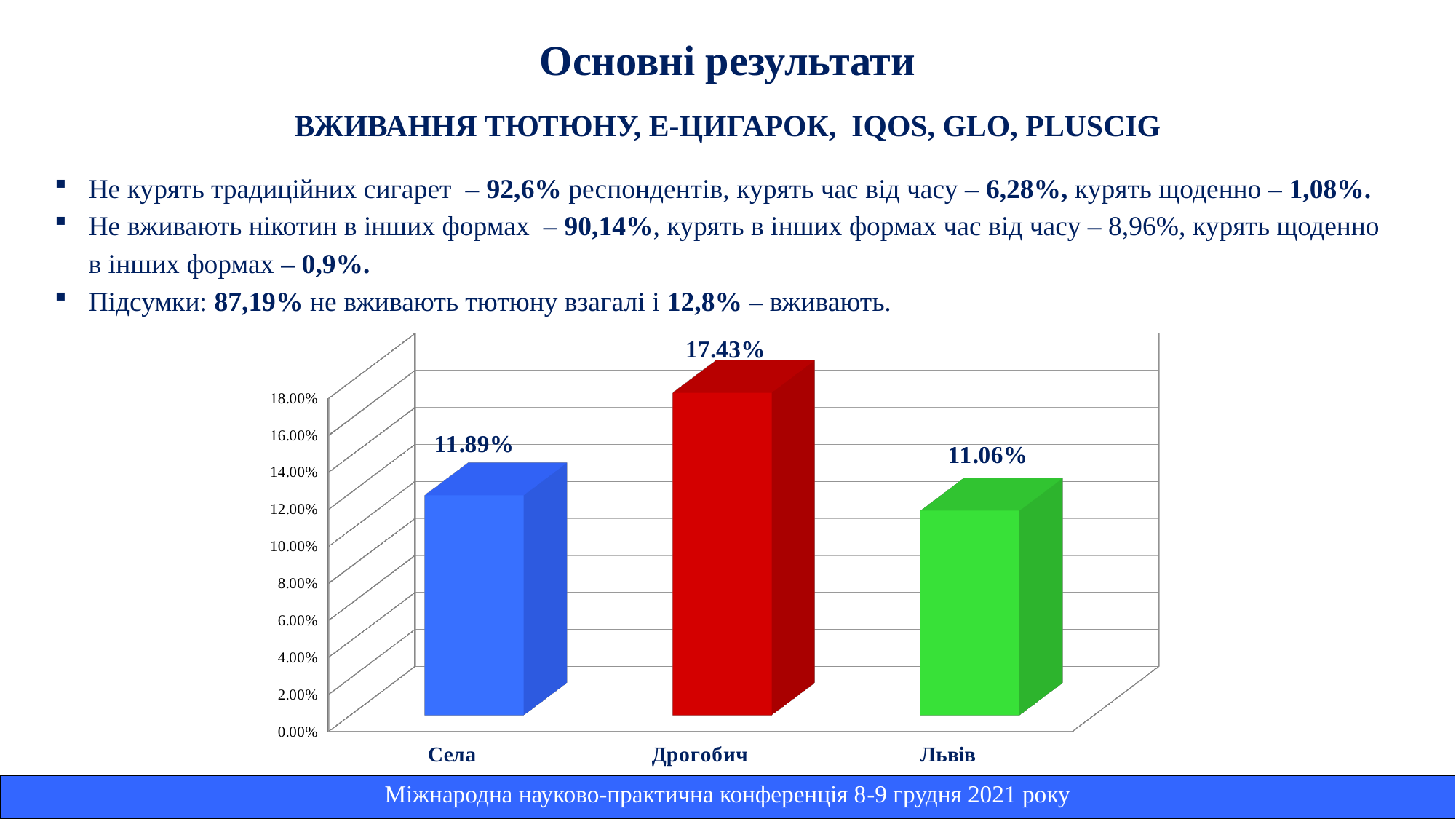
Which category has the highest value? Дрогобич What is the difference between the values for Дрогобич and Села? 5.54% Is the value for Дрогобич greater or less than 16.00%? greater Which is larger, the value for Дрогобич or the value for Львів? Дрогобич What is the value for Львів? 11.06% How many categories are shown on the x axis? 3 What is the value for Села? 11.89% What colour is the bar for Дрогобич? red What is the value for Дрогобич? 17.43% What kind of chart is shown on the slide? bar chart Which category has the lowest value? Львів What is the difference between the values for Села and Львів? 0.83%